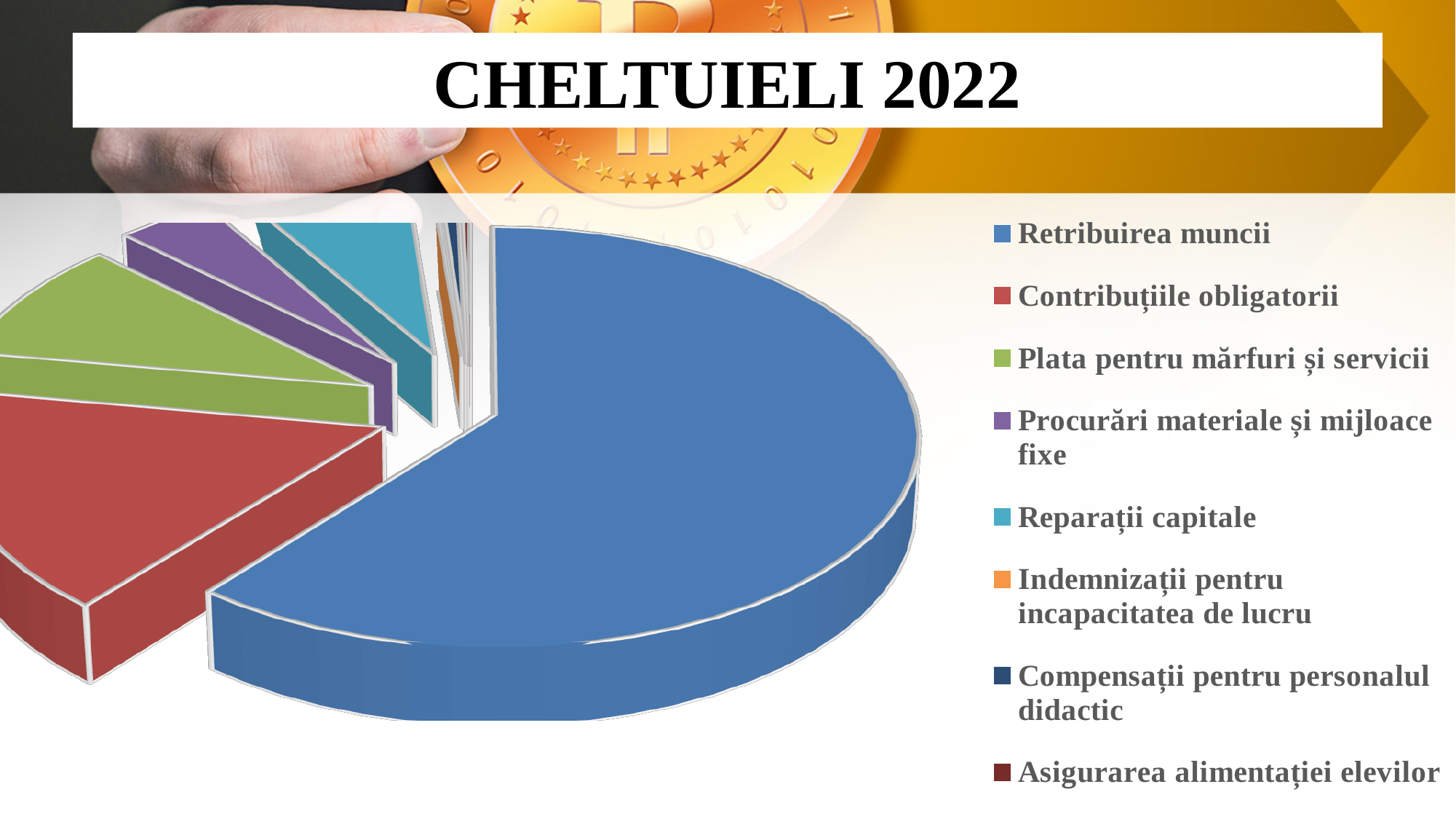
Which category is listed last in the legend of the pie chart? Asigurarea alimentației elevilor Which slice is larger: Retribuirea muncii or Contribuțiile obligatorii? Retribuirea muncii Which slice is larger: Plata pentru mărfuri și servicii or Procurări materiale și mijloace fixe? Plata pentru mărfuri și servicii Which slice is larger: Contribuțiile obligatorii or Reparații capitale? Contribuțiile obligatorii What kind of chart is shown on the slide? pie chart What colour is the slice for Retribuirea muncii in the pie chart? blue Which category has the largest slice of the pie chart? Retribuirea muncii What is the title of the chart on the slide? CHELTUIELI 2022 How many categories does the legend of the pie chart list? 8